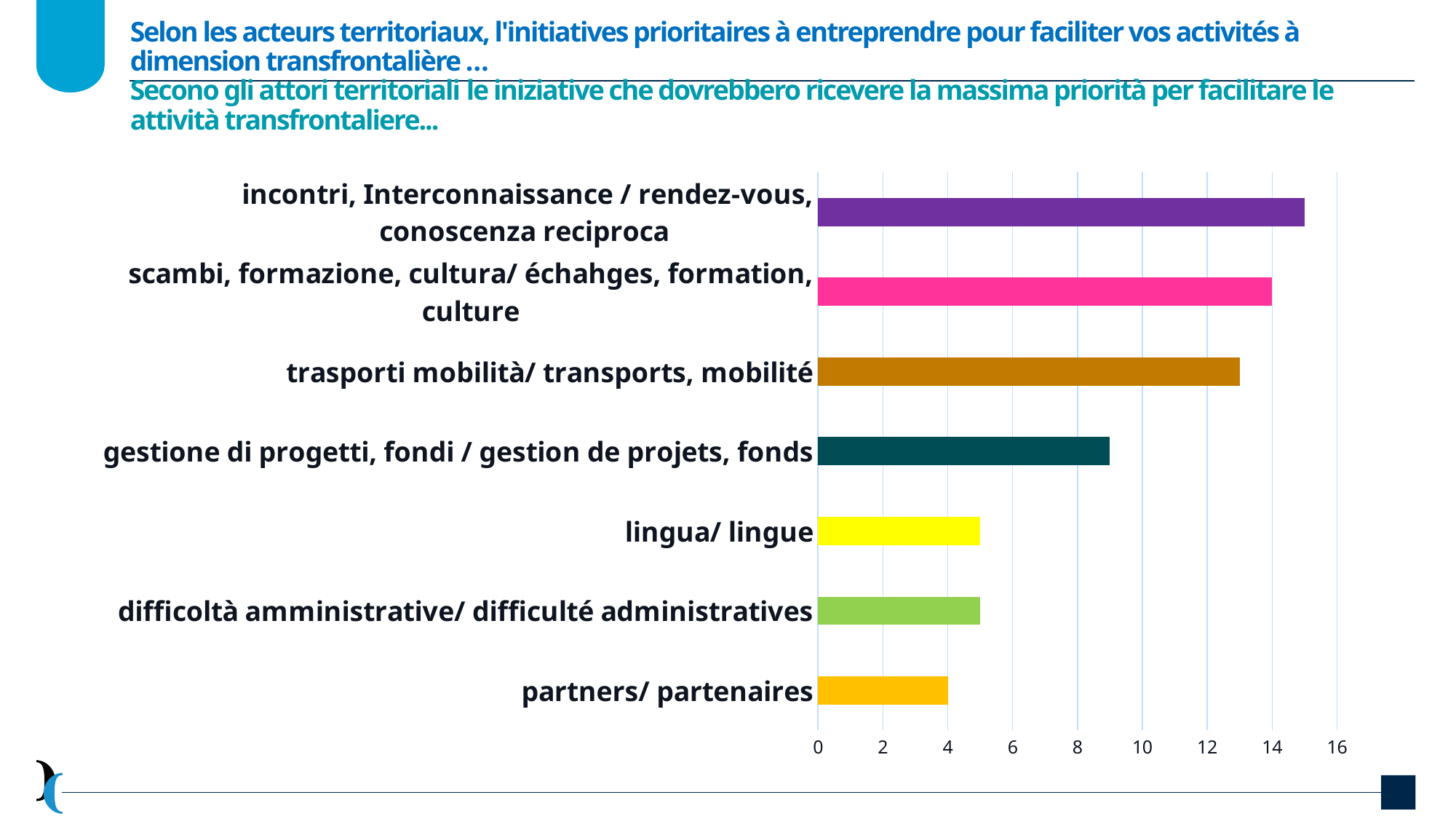
How many categories are plotted in the chart? 7 Which category has the highest value? incontri, Interconnaissance / rendez-vous, conoscenza reciproca What is the value for scambi, formazione, cultura/ échahges, formation, culture? 14 What is the highest tick value shown on the horizontal axis? 16 Is the value for gestione di progetti, fondi / gestion de projets, fonds greater or less than 10? less Which is larger: the value for trasporti mobilità/ transports, mobilité or the value for gestione di progetti, fondi / gestion de projets, fonds? trasporti mobilità/ transports, mobilité Is the value for trasporti mobilità/ transports, mobilité greater or less than 12? greater Which category has the lowest value? partners/ partenaires Is the value for incontri, Interconnaissance / rendez-vous, conoscenza reciproca greater or less than 14? greater What is the value for partners/ partenaires? 4 What is the difference between the value for scambi, formazione, cultura/ échahges, formation, culture and the value for partners/ partenaires? 10 What kind of chart is shown on the slide? bar chart